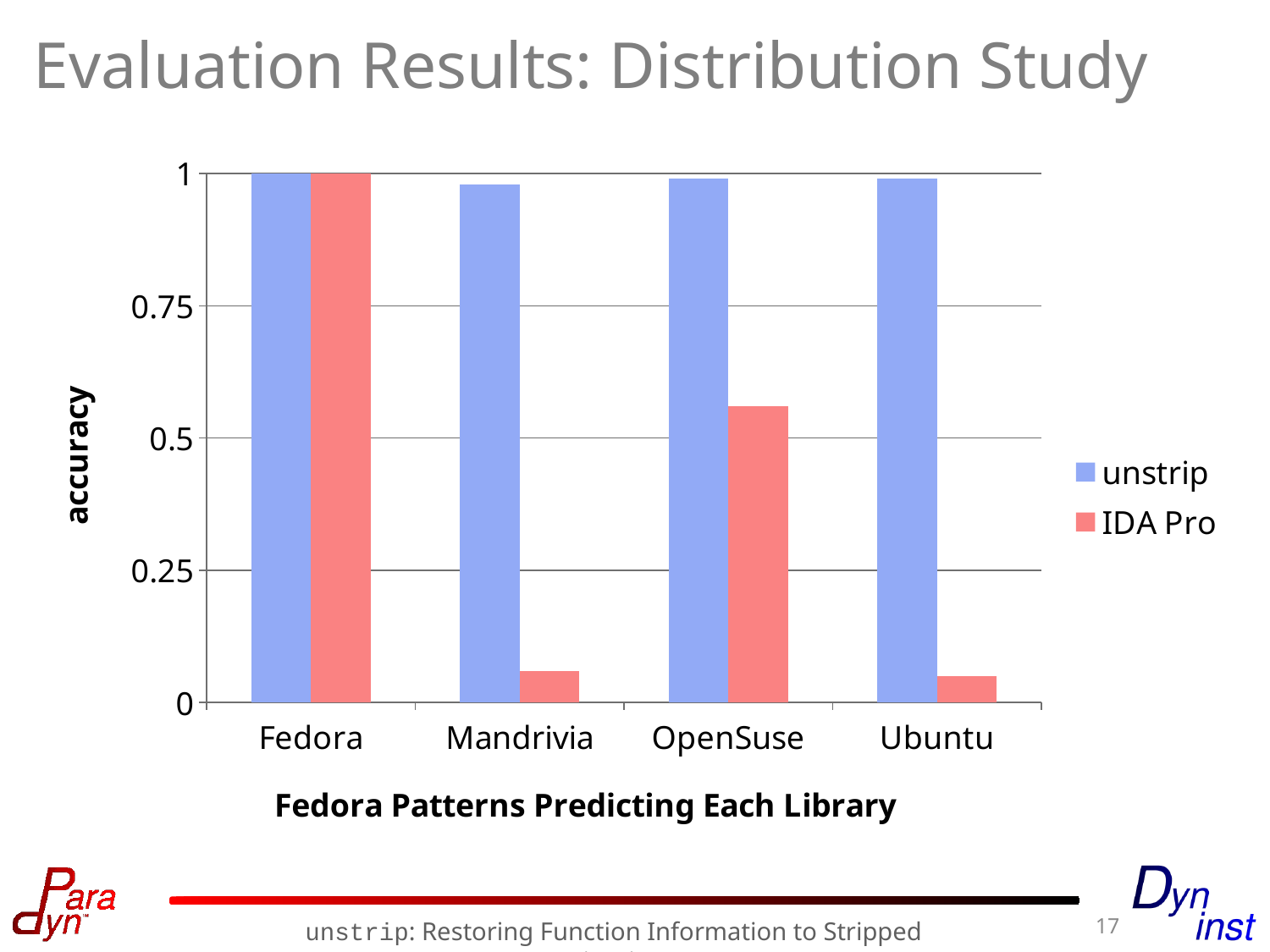
Which is larger, the IDA Pro accuracy for Fedora or for OpenSuse? Fedora How many series does the legend list? 2 For which distribution is the IDA Pro accuracy highest? Fedora Which series is drawn in red/pink bars? IDA Pro For OpenSuse, which has the higher accuracy, unstrip or IDA Pro? unstrip Is the IDA Pro accuracy for OpenSuse greater or less than 0.5? greater Is the IDA Pro accuracy for Mandrivia greater or less than 0.25? less What is the label on the y axis? accuracy What is the accuracy of unstrip for Fedora? 1 How many distributions (categories) are shown on the x axis? 4 What kind of chart is shown on the slide? bar chart Is the unstrip accuracy for Ubuntu greater or less than 0.75? greater